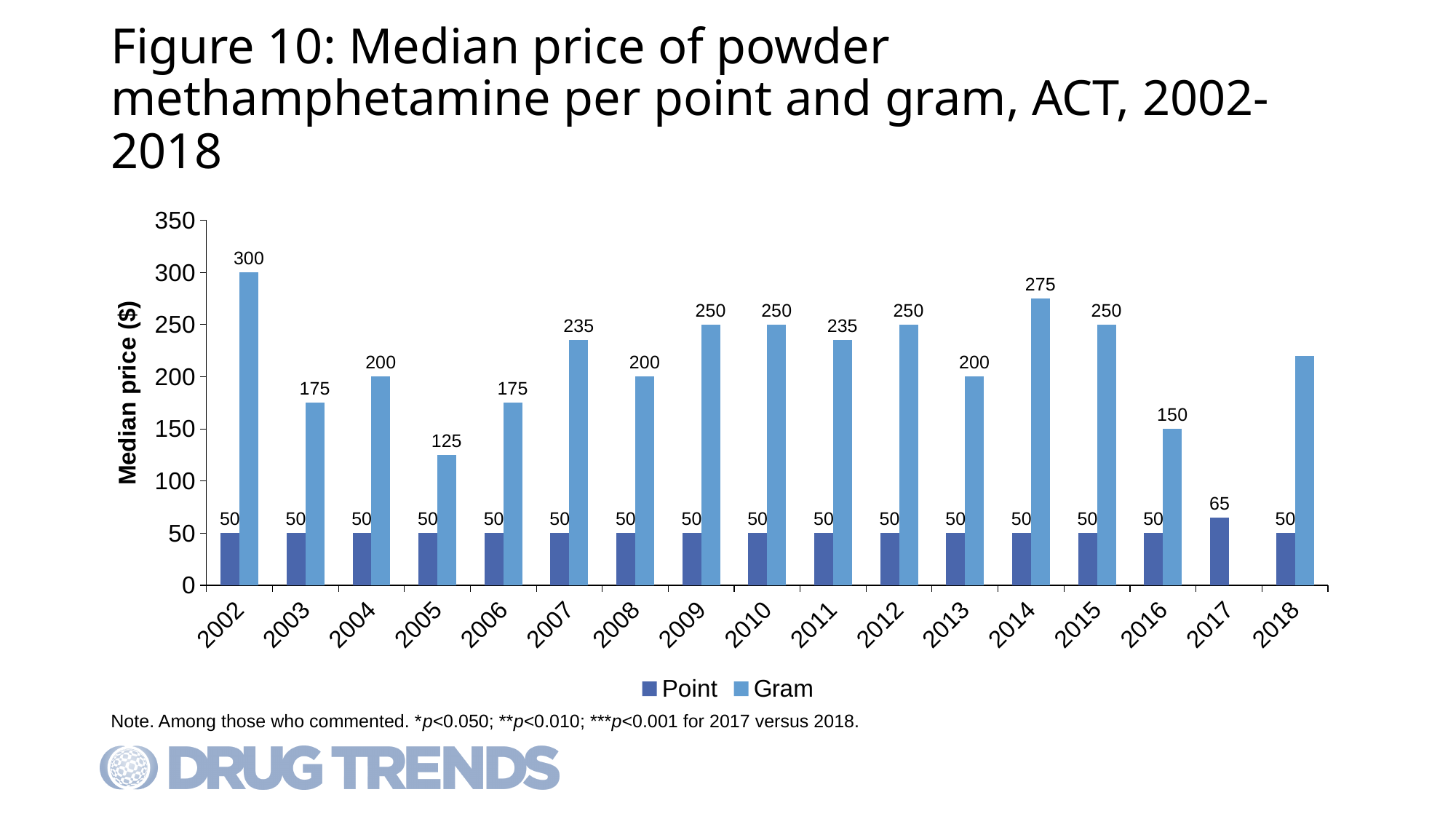
What kind of chart is shown on the slide? bar chart In which year is the labelled median price per gram lowest? 2005 In which year is the median price per gram highest? 2002 How many series does the legend list? 2 What is the difference between the median price per gram in 2002 and in 2005? 175 What is the median price per gram in 2002? 300 How many years are shown on the x axis? 17 Which year has the higher median price per gram, 2007 or 2008? 2007 What is the median price per gram in 2014? 275 What is the label on the vertical axis? Median price ($) What is the median price per point in 2017? 65 Is the median price per gram in 2018 greater or less than 200? greater